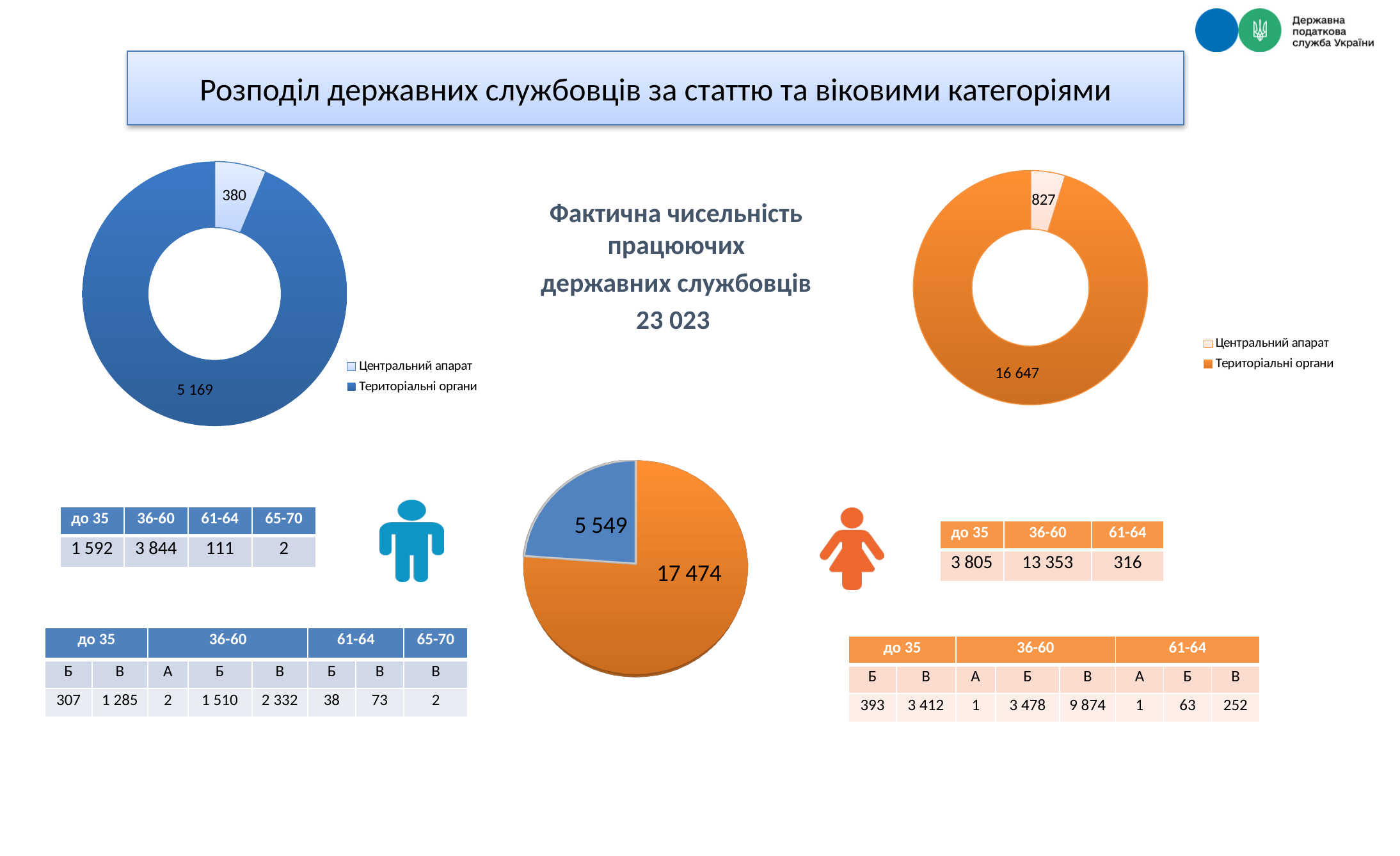
On the pie chart in the centre of the slide, what is the difference between the orange slice and the blue slice? 11 925 On the pie chart in the centre of the slide, what is the value of the smaller blue slice? 5 549 On the orange doughnut chart at the top right, what is the value for Центральний апарат? 827 Which is larger: Центральний апарат on the orange doughnut chart at the top right or Центральний апарат on the blue doughnut chart at the top left? the orange doughnut chart (827) How many entries does the legend of the blue doughnut chart at the top left list? 2 On the blue doughnut chart at the top left, what is the value for Територіальні органи? 5 169 On the pie chart in the centre of the slide, what is the value of the larger orange slice? 17 474 On the blue doughnut chart at the top left, what is the value for Центральний апарат? 380 On the blue doughnut chart at the top left, what is the difference between Територіальні органи and Центральний апарат? 4 789 What kind of chart is the chart in the centre of the slide? pie chart On the orange doughnut chart at the top right, what is the value for Територіальні органи? 16 647 On the orange doughnut chart at the top right, what is the difference between Територіальні органи and Центральний апарат? 15 820